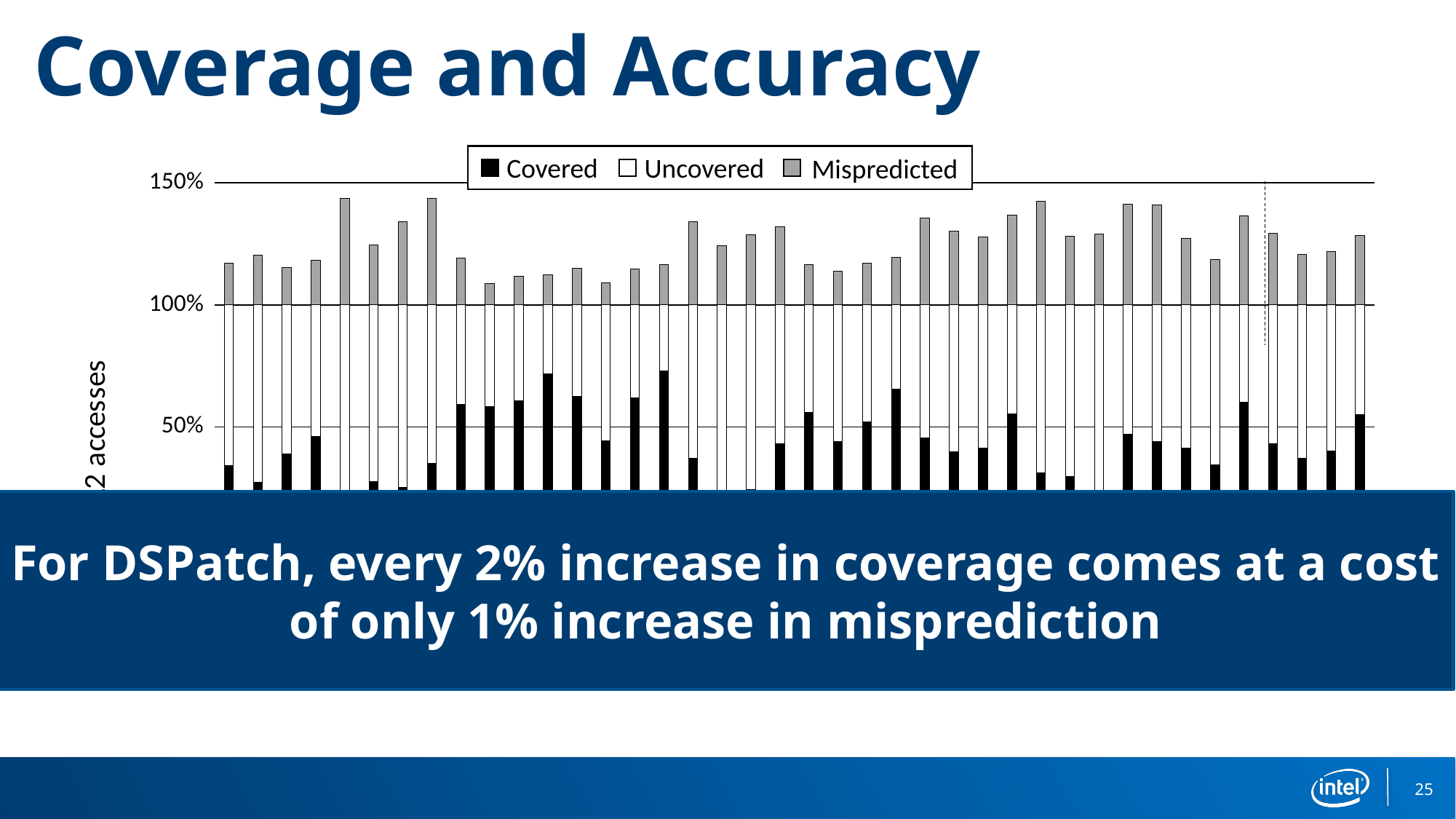
How many series does the legend list? 3 What kind of chart is shown on the slide? stacked bar chart Which series is drawn in grey in the chart? Mispredicted What is the highest tick label shown on the y axis of the chart? 150% Which series is drawn in black in the chart? Covered